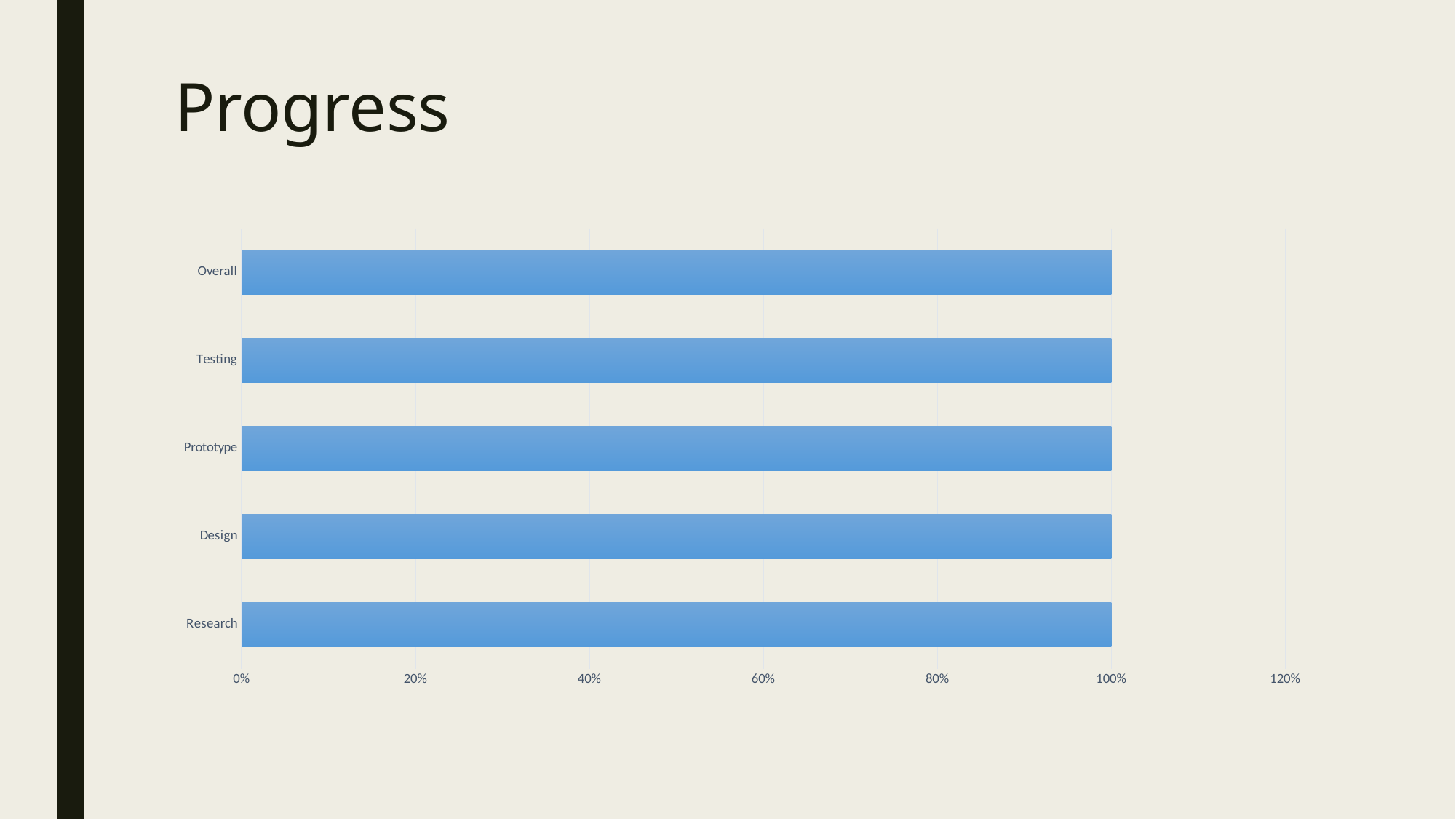
What is the value for Design? 100% What is the value for Research? 100% Is the value for Research greater or less than 60%? greater What type of chart is shown on the slide? bar chart What is the highest value shown on the horizontal axis? 120% Is the value for Testing greater or less than 80%? greater What is the value for Testing? 100% What is the value for Prototype? 100% What is the value for Overall? 100% What is the difference between the values for Overall and Design? 0% How many categories are plotted in the chart? 5 Which category is listed at the top of the chart? Overall